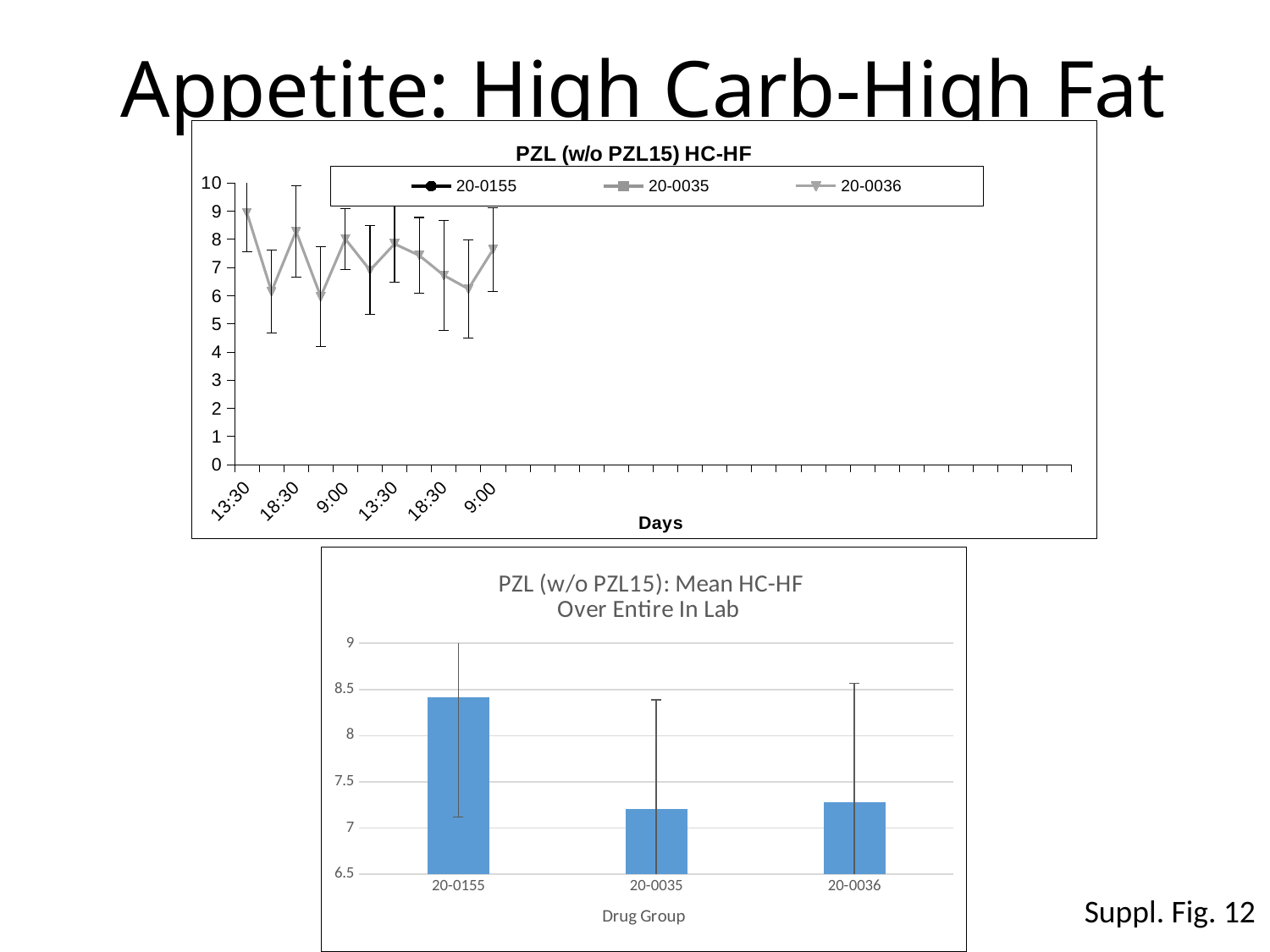
In the bottom chart, which is larger, the value for 20-0155 or the value for 20-0035? 20-0155 In the bottom chart, which drug group has the highest mean value? 20-0155 What kind of chart is the bottom chart titled "PZL (w/o PZL15): Mean HC-HF Over Entire In Lab"? bar chart In the bottom chart, is the value for 20-0036 greater or less than 7.5? less What is the x-axis title of the top chart? Days In the bottom chart, is the value for 20-0155 greater or less than 8? greater What kind of chart is the top chart titled "PZL (w/o PZL15) HC-HF"? line chart What is the x-axis title of the bottom chart? Drug Group In the bottom chart, how many drug groups are shown on the x axis? 3 How many series does the legend of the top chart list? 3 In the bottom chart, is the value for 20-0035 greater or less than 7.5? less